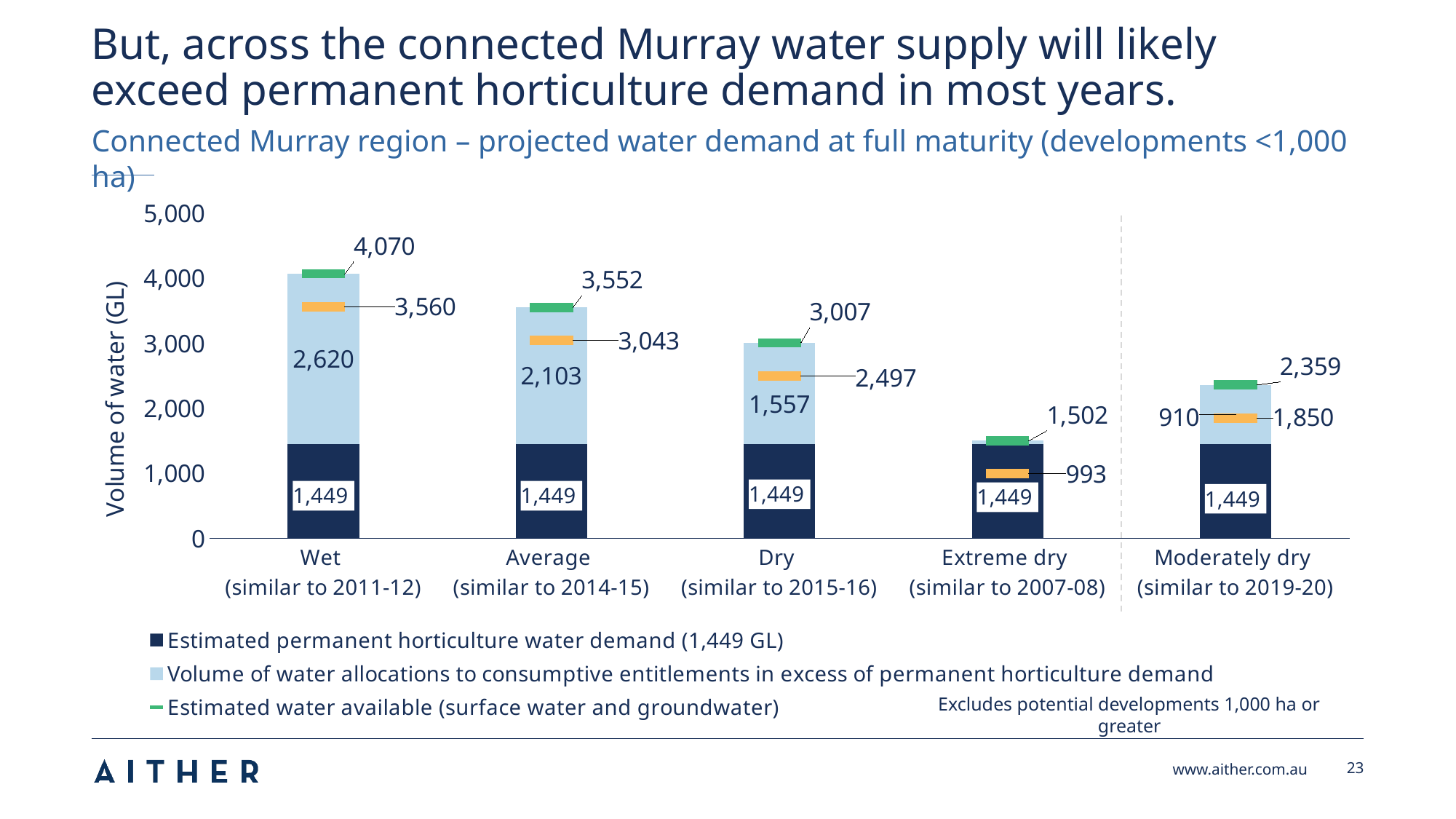
Which scenario has the highest estimated water available? Wet How many series does the legend list? 3 What is the total of the stacked bar for the Average scenario? 3,552 What is the difference between the estimated water available in the Wet scenario and the Average scenario? 518 What is the estimated water available (surface water and groundwater) for the Wet scenario? 4,070 What is the estimated permanent horticulture water demand shown for the Dry scenario? 1,449 What value is labelled on the orange marker for the Extreme dry scenario? 993 How many scenarios are shown on the x axis? 5 Is the estimated water available higher for the Dry scenario or the Moderately dry scenario? Dry What is the volume of water allocations in excess of permanent horticulture demand for the Average scenario? 2,103 Which scenario has the lowest estimated water available? Extreme dry Is the estimated water available for the Moderately dry scenario greater or less than 2,000? greater